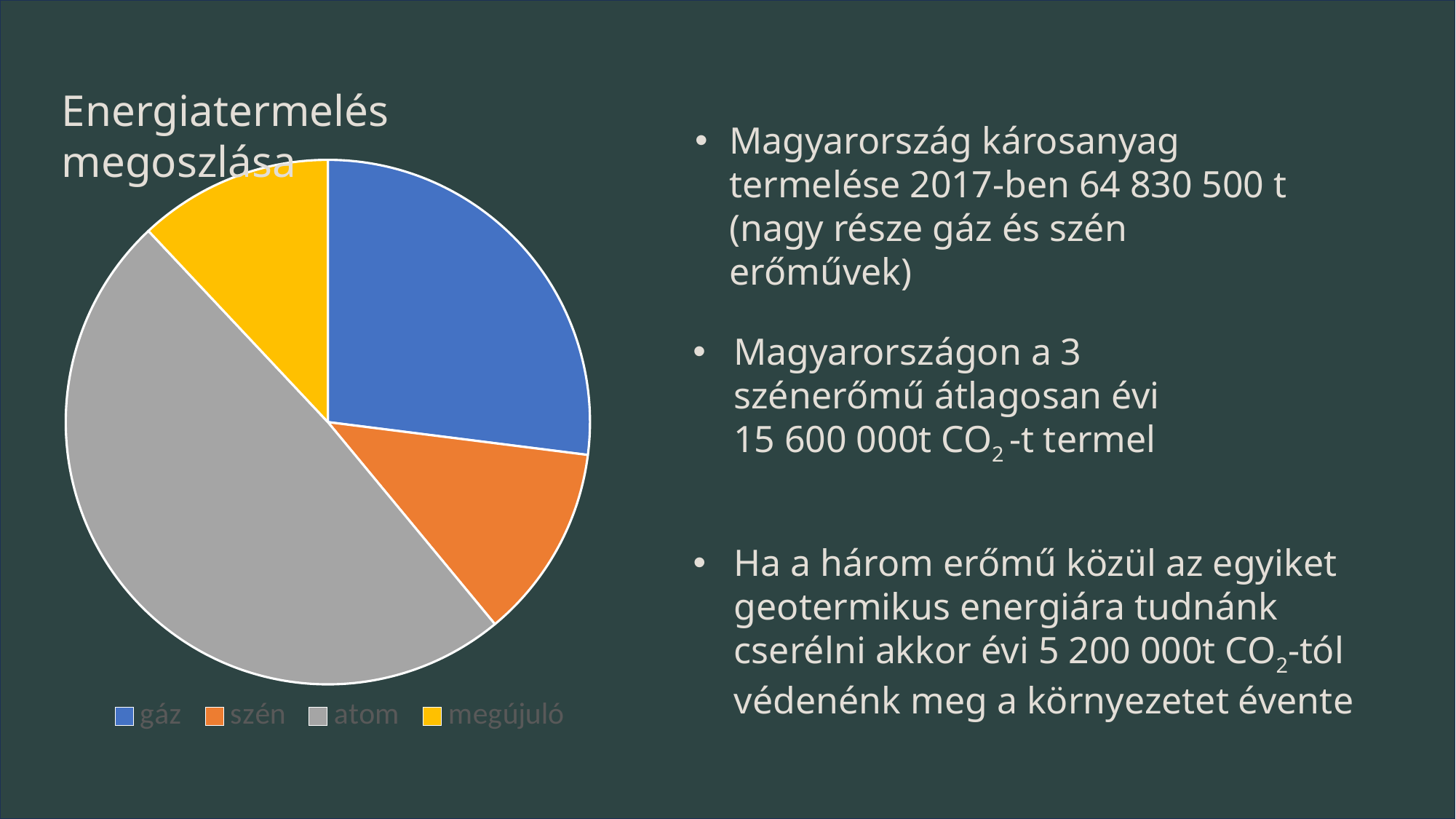
Which is larger, the slice for atom or the slice for gáz? atom Which category has the largest slice of the pie? atom How many slices does the pie chart have? 4 What kind of chart is shown on the slide? pie chart Which is larger, the slice for atom or the slice for megújuló? atom How many entries does the legend list? 4 Which colour represents megújuló in the pie chart? yellow Which is larger, the slice for gáz or the slice for megújuló? gáz What is the title of the chart? Energiatermelés megoszlása